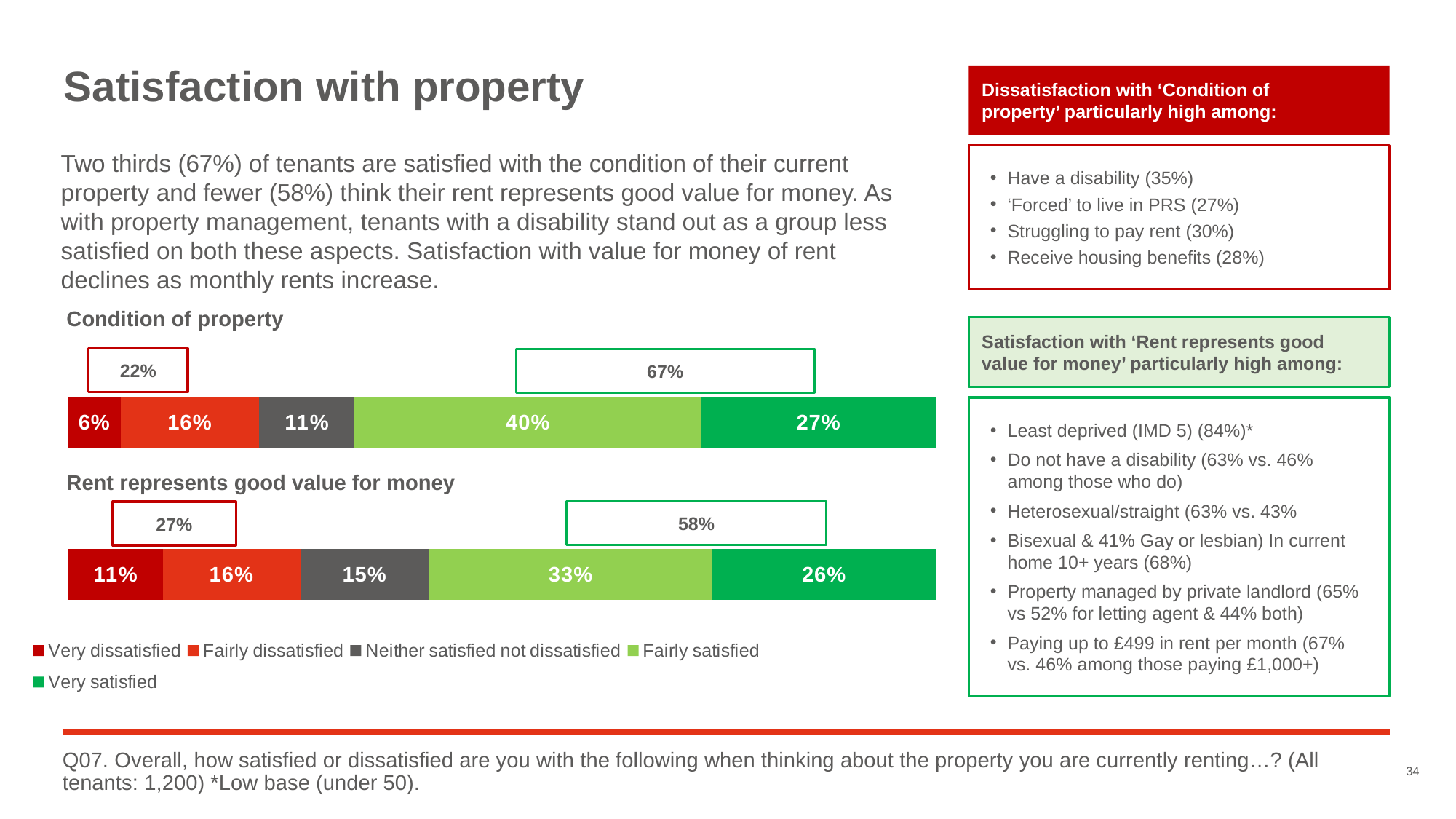
What is the difference between the 'Fairly satisfied' share in the 'Condition of property' chart and in the 'Rent represents good value for money' chart? 7 percentage points What is the combined satisfied (fairly plus very satisfied) share shown above the 'Condition of property' bar? 67% Is the 'Very dissatisfied' share larger in the 'Condition of property' chart or in the 'Rent represents good value for money' chart? Rent represents good value for money How many series does the legend list for the charts? 5 In the 'Rent represents good value for money' chart, what percentage of tenants are neither satisfied nor dissatisfied? 15% What type of chart is used to show satisfaction with 'Condition of property'? Stacked bar chart In the 'Condition of property' chart, what percentage of tenants are fairly satisfied? 40% In the 'Condition of property' chart, which response category has the largest share? Fairly satisfied In the 'Rent represents good value for money' chart, what percentage of tenants are very satisfied? 26% In the 'Condition of property' chart, what percentage of tenants are very dissatisfied? 6% In the 'Rent represents good value for money' chart, which response category has the smallest share? Very dissatisfied What is the combined dissatisfied share shown above the 'Rent represents good value for money' bar? 27%